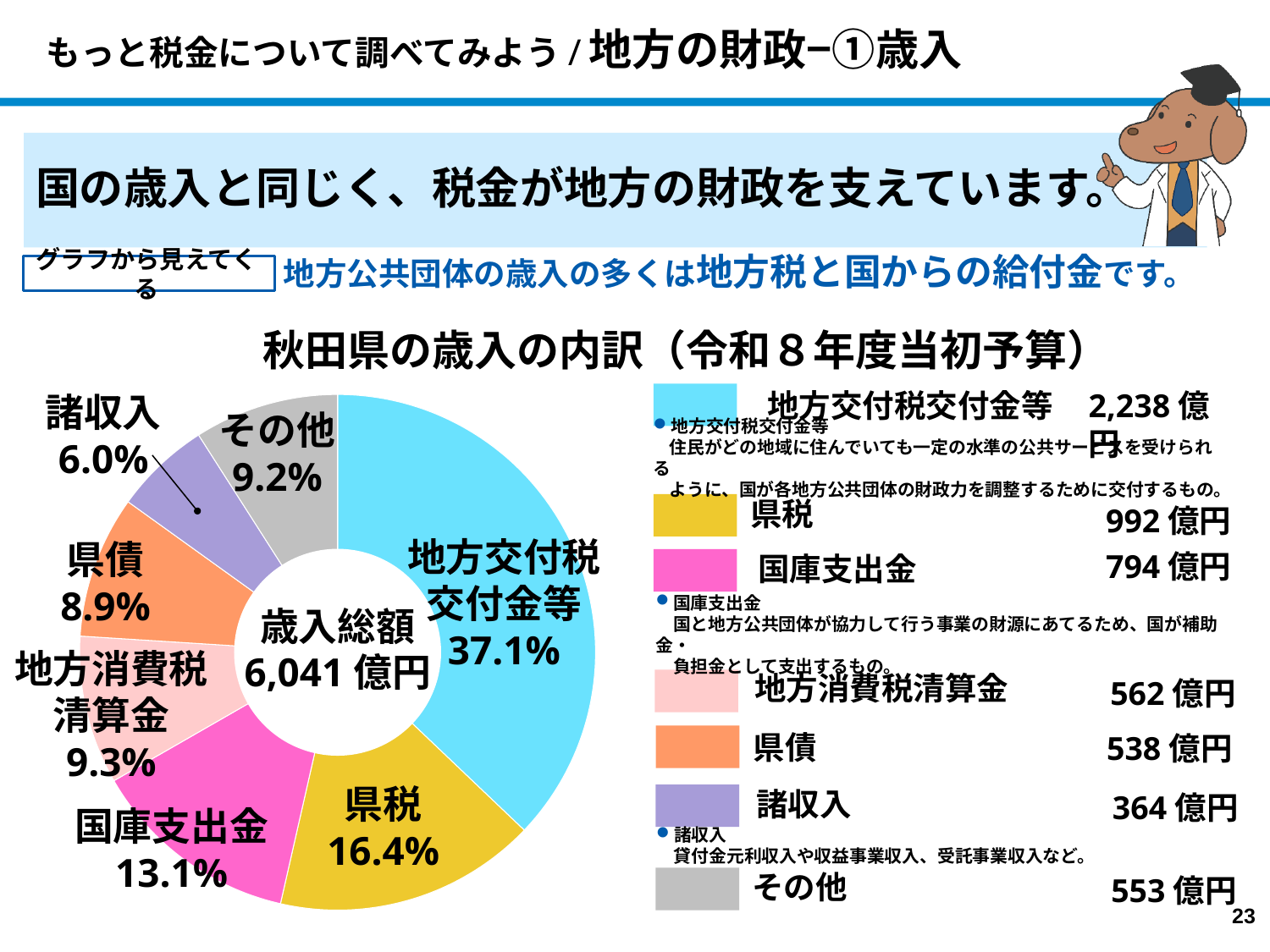
円グラフで最も割合が小さい項目はどれですか？ 諸収入 円グラフには項目がいくつありますか？ 7 このグラフの種類は何ですか？ 円グラフ（ドーナツグラフ） 円グラフで最も割合が大きい項目はどれですか？ 地方交付税交付金等 円グラフで「県税」の割合は何%ですか？ 16.4% 円グラフで「地方交付税交付金等」の割合は何%ですか？ 37.1% このグラフのタイトルは何ですか？ 秋田県の歳入の内訳（令和８年度当初予算） グラフの中央に示されている歳入総額はいくらですか？ 6,041 億円 「県税」と「国庫支出金」の割合の差は何ポイントですか？ 3.3% 凡例に示されている「諸収入」の金額はいくらですか？ 364 億円 凡例に示されている「国庫支出金」の金額はいくらですか？ 794 億円 「地方消費税清算金」と「県債」では、どちらの割合が大きいですか？ 地方消費税清算金